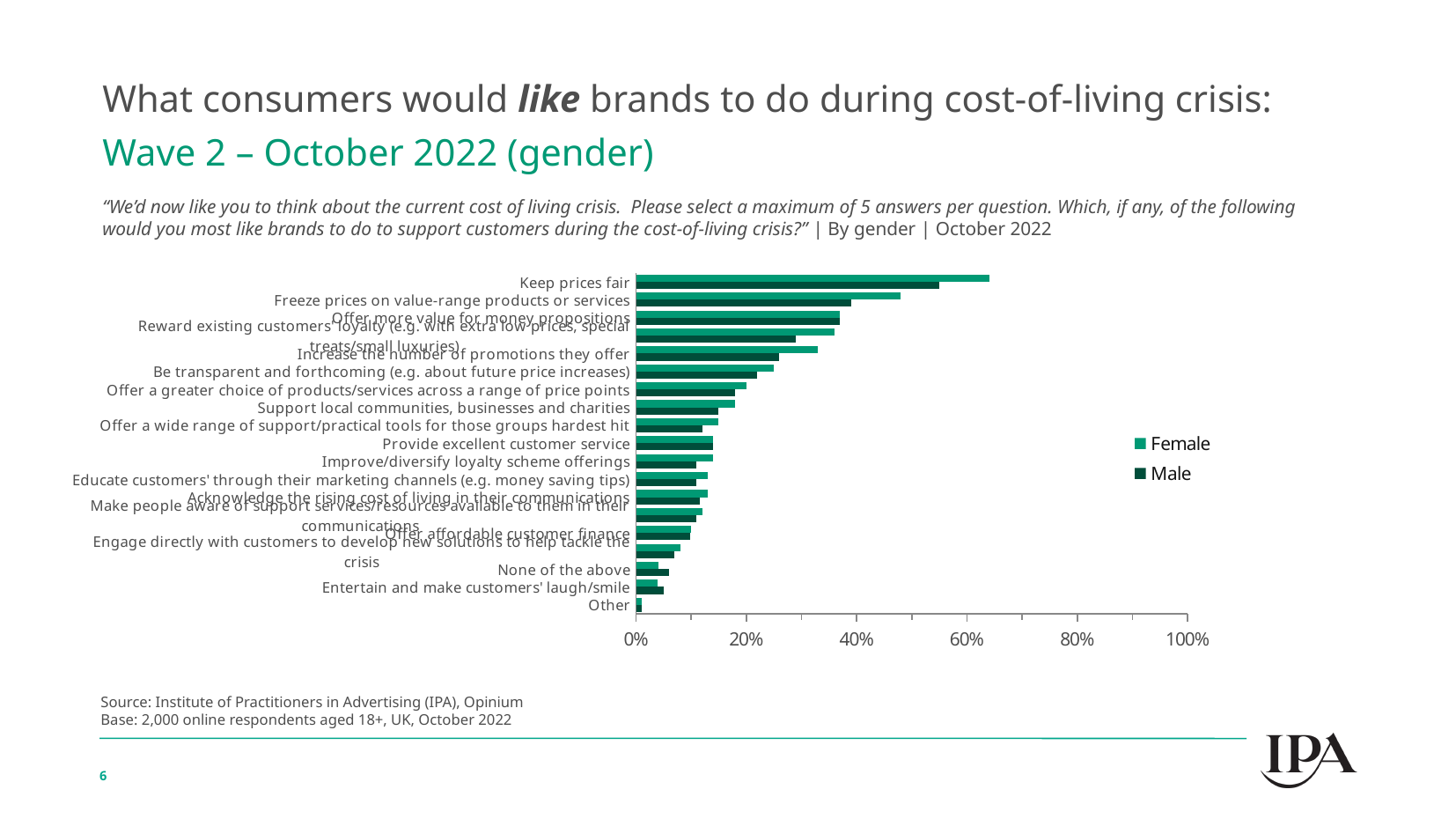
Is the Female value for 'Keep prices fair' greater or less than 60%? greater Do the Female values rise or fall going from the top category to the bottom category? fall Which category has the lowest value for the Female series? Other What kind of chart is shown on the slide? Bar chart How many series does the legend list? 2 Is the Female value for 'Entertain and make customers' laugh/smile' greater or less than 20%? less Is the Female value for 'Freeze prices on value-range products or services' greater or less than 40%? greater What are the two series named in the legend? Female and Male For 'Keep prices fair', which is larger: the Female value or the Male value? Female Which category has the highest value for the Female series? Keep prices fair